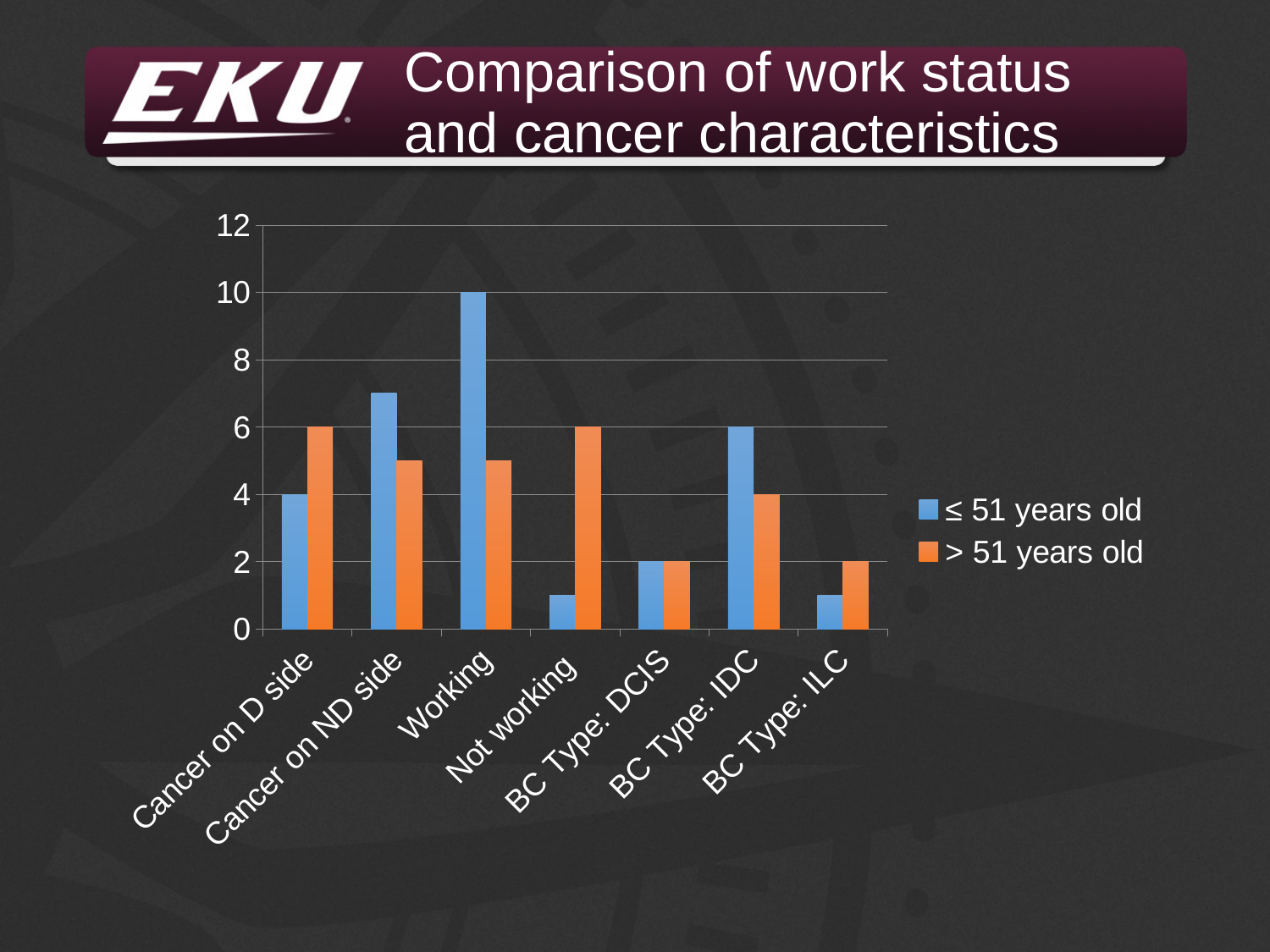
Which category has the highest value in the ≤ 51 years old series? Working What type of chart is shown on the slide? Bar chart For Not working, which series has the larger value, ≤ 51 years old or > 51 years old? > 51 years old How many series does the legend list? 2 How many categories are shown on the x axis? 7 What is the difference between the > 51 years old and ≤ 51 years old values for Cancer on D side? 2 What is the value for BC Type: IDC in the ≤ 51 years old series? 6 What is the value for Working in the ≤ 51 years old series? 10 Is the value for Cancer on ND side in the ≤ 51 years old series greater or less than 6? greater What is the value for Cancer on D side in the > 51 years old series? 6 Is the value for Working in the > 51 years old series greater or less than 6? less What colour represents the > 51 years old series? Orange